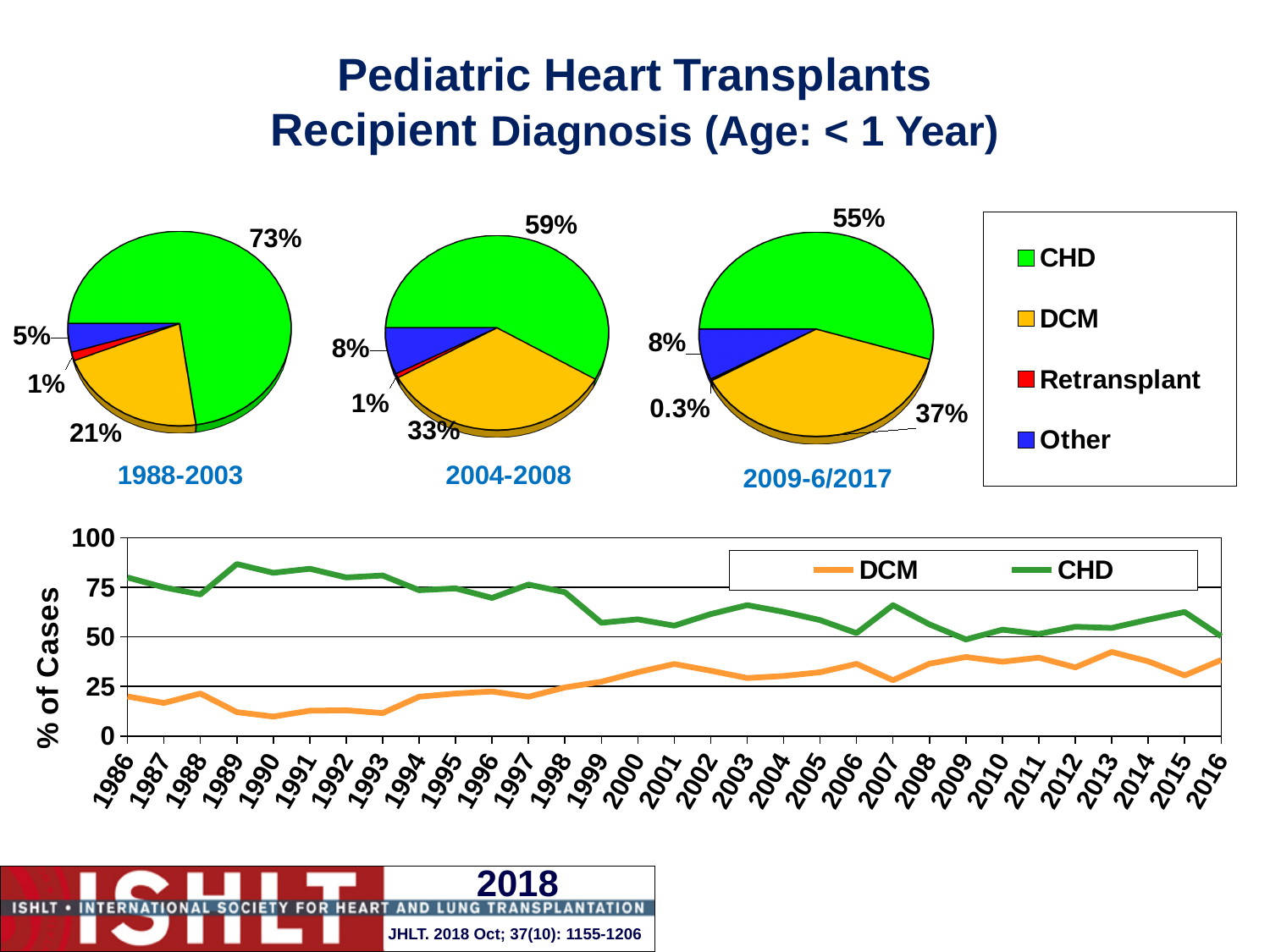
In the bottom line chart, is the CHD value for 1989 greater or less than 75? greater In the 2004-2008 pie chart, which diagnosis has the largest slice? CHD How many series does the legend of the bottom chart list? 2 Comparing the pie charts, is the CHD share larger in 1988-2003 or in 2009-6/2017? 1988-2003 In the 2009-6/2017 pie chart, what percentage of cases is DCM? 37% In the bottom line chart, does the DCM line generally rise or fall from 1986 to 2016? Rise What kind of chart is the bottom chart showing % of Cases by year? Line chart In the 1988-2003 pie chart, what percentage of cases is CHD? 73% In the 2009-6/2017 pie chart, which diagnosis has the smallest slice? Retransplant In the 2004-2008 pie chart, what percentage of cases is Other? 8% How many years are shown on the x axis of the bottom line chart? 31 In the 1988-2003 pie chart, how much larger is the CHD share than the DCM share? 52%